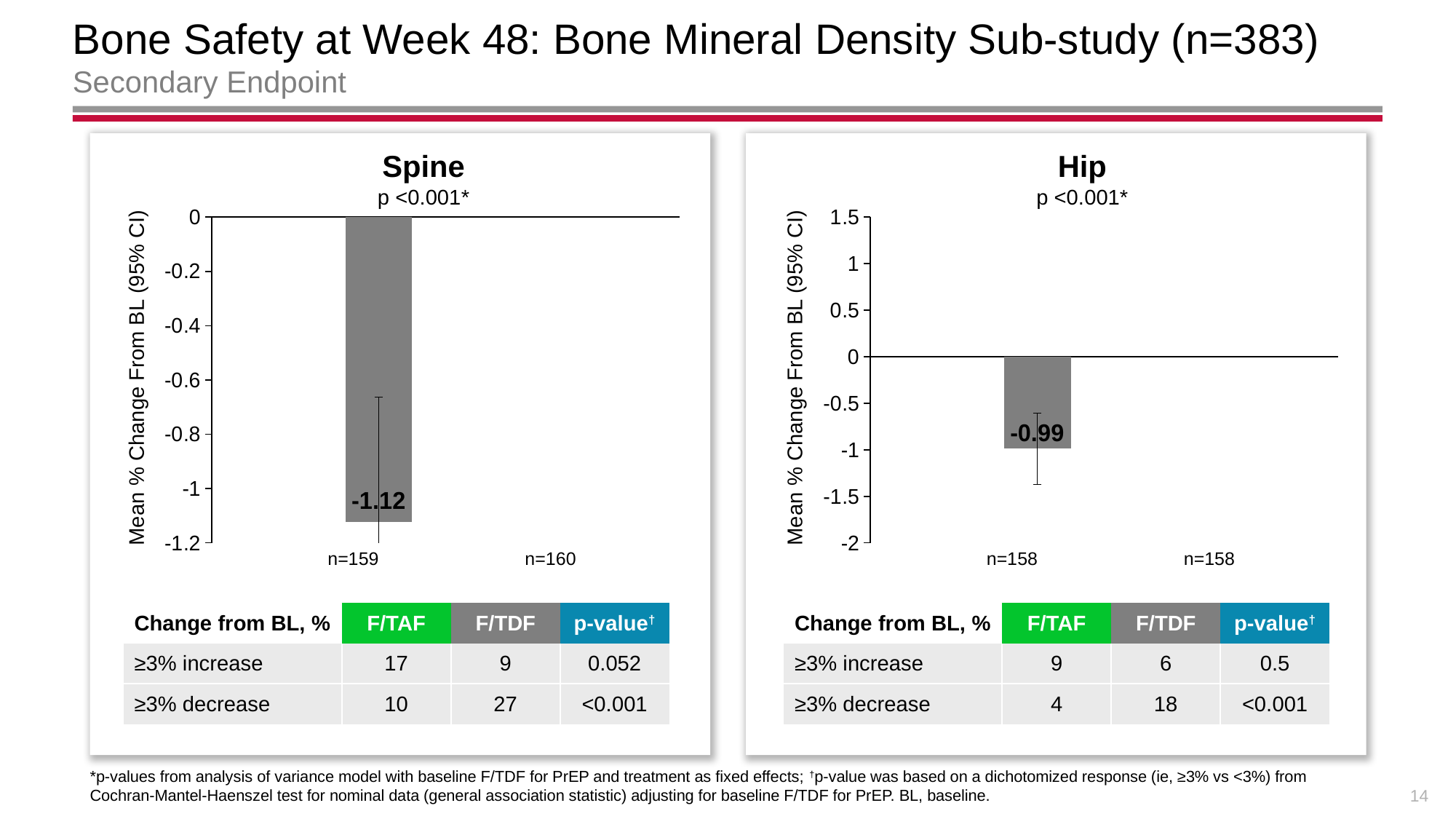
In the Hip chart, is the value of the plotted bar greater or less than -0.5? less Which chart shows the larger decrease from baseline, Spine or Hip? Spine In the Spine chart, is the value of the plotted bar greater or less than -1? less What p-value is shown under the title of the Spine chart? p <0.001* What kind of chart is the Spine chart? bar chart What is the difference between the bar value in the Spine chart (-1.12) and the bar value in the Hip chart (-0.99)? 0.13 In the Hip chart, what value is printed on the plotted bar? -0.99 In the Spine chart, what value is printed on the plotted bar? -1.12 What is the y-axis label of the Hip chart? Mean % Change From BL (95% CI) How many bars are plotted in the Hip chart? 1 How many bars are plotted in the Spine chart? 1